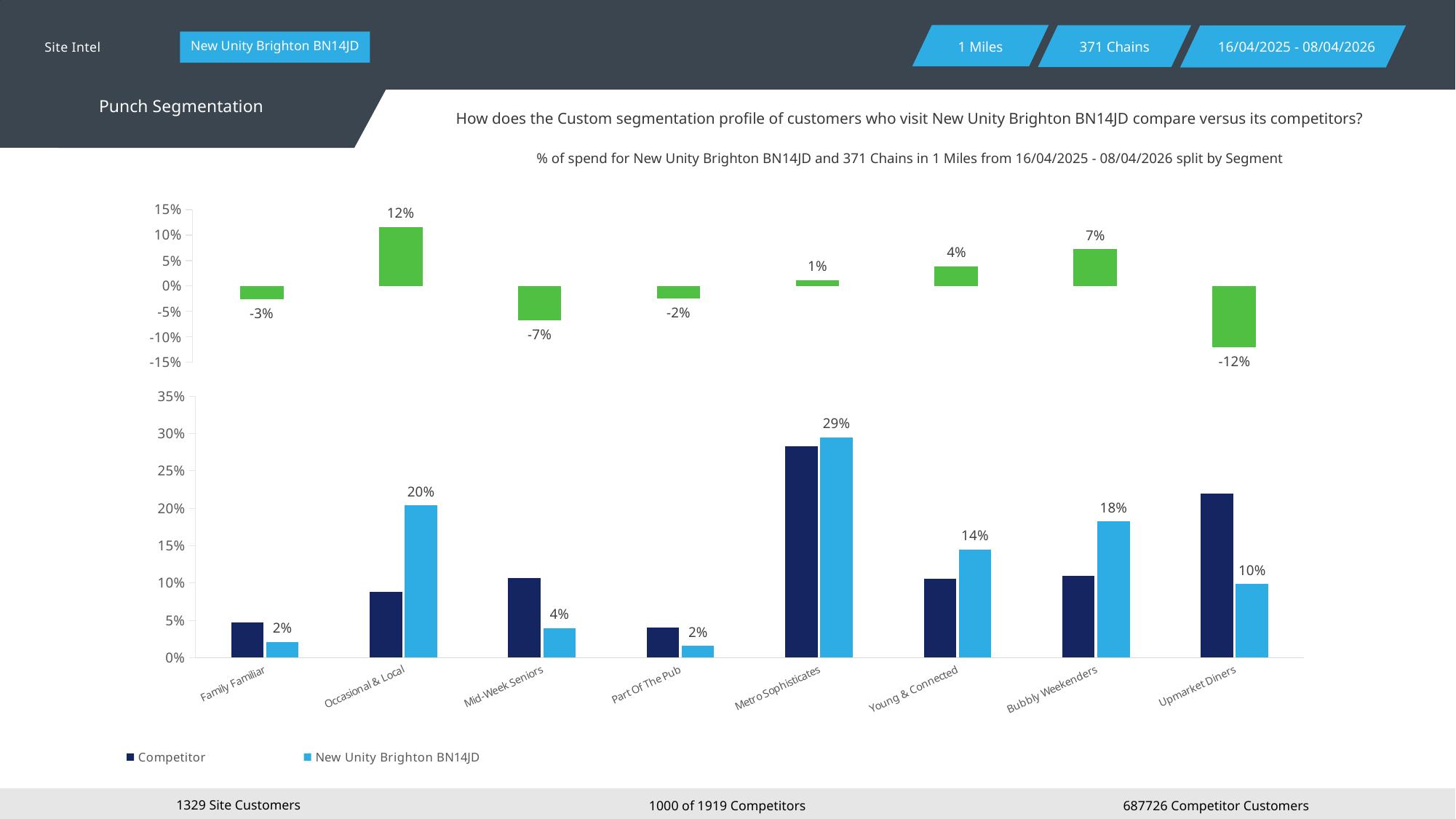
In the top chart, which segment has the highest value? Occasional & Local In the top chart, what is the difference between the values for Bubbly Weekenders and Young & Connected? 3% In the bottom chart, what is the value for New Unity Brighton BN14JD in the Metro Sophisticates segment? 29% In the bottom chart, which segment has the highest value for New Unity Brighton BN14JD? Metro Sophisticates In the bottom chart, which is larger for Mid-Week Seniors: the Competitor bar or the New Unity Brighton BN14JD bar? Competitor In the top chart, what is the value for Upmarket Diners? -12% In the top chart, what is the value for Occasional & Local? 12% In the bottom chart, what is the value for New Unity Brighton BN14JD in the Bubbly Weekenders segment? 18% In the top chart, which segment has the lowest value? Upmarket Diners In the bottom chart, is the Competitor value for Upmarket Diners greater or less than 20%? greater How many series does the legend of the bottom chart list? 2 How many segments are shown on the x axis of the bottom chart? 8